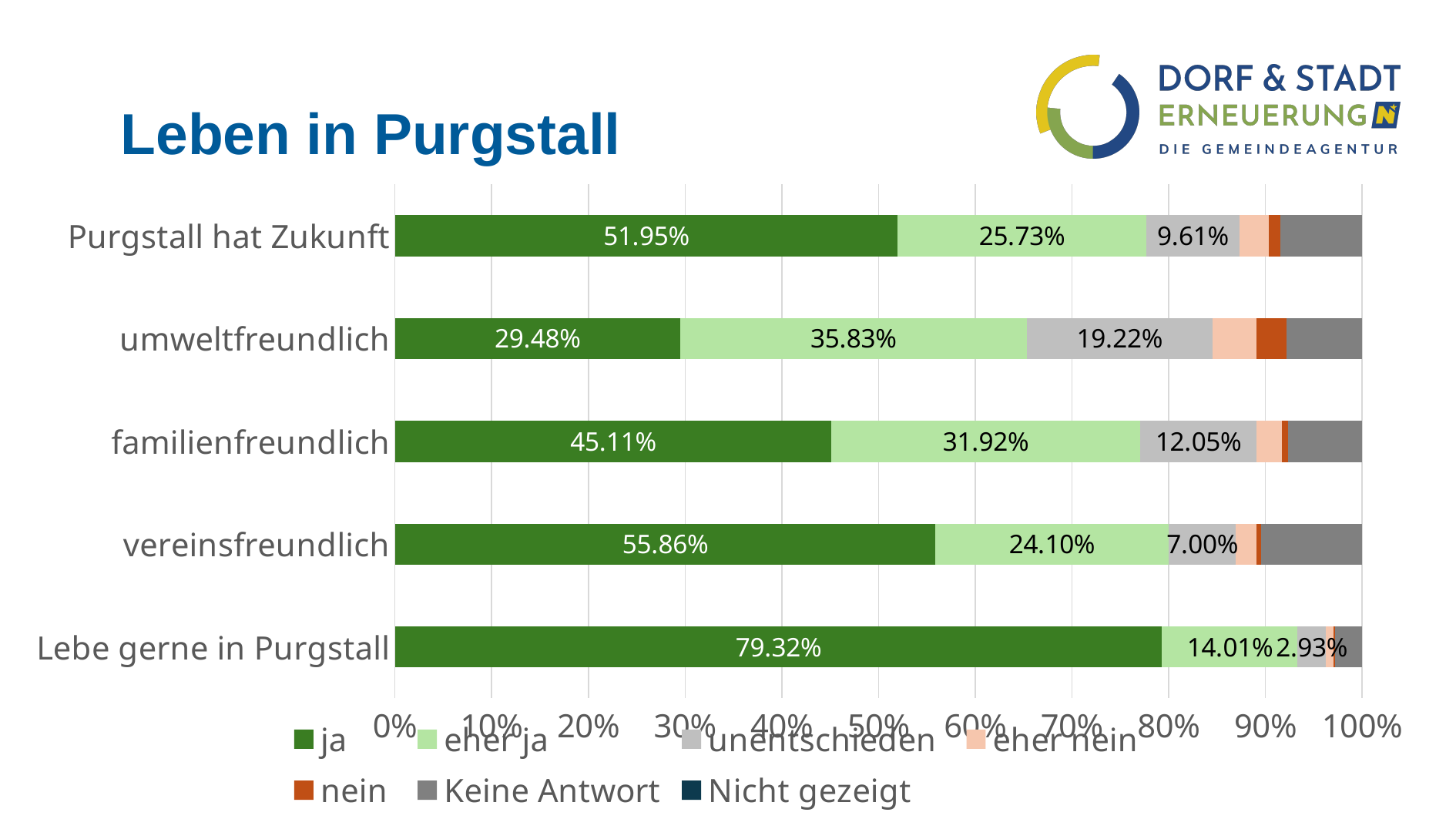
What is the 'ja' value for 'Lebe gerne in Purgstall'? 79.32% What is the 'ja' value for 'vereinsfreundlich'? 55.86% What is the 'eher ja' value for 'umweltfreundlich'? 35.83% What is the difference between the 'ja' values for 'Purgstall hat Zukunft' and 'familienfreundlich'? 6.84% How many series does the legend list? 7 Which category has the lowest 'ja' value? umweltfreundlich What kind of chart is shown on the slide? Stacked bar chart Which is larger: the 'unentschieden' value for 'umweltfreundlich' or for 'Purgstall hat Zukunft'? umweltfreundlich What is the 'unentschieden' value for 'familienfreundlich'? 12.05% Which category has the highest 'ja' value? Lebe gerne in Purgstall Is the 'ja' value for 'vereinsfreundlich' greater or less than 50%? greater How many categories are shown on the chart? 5